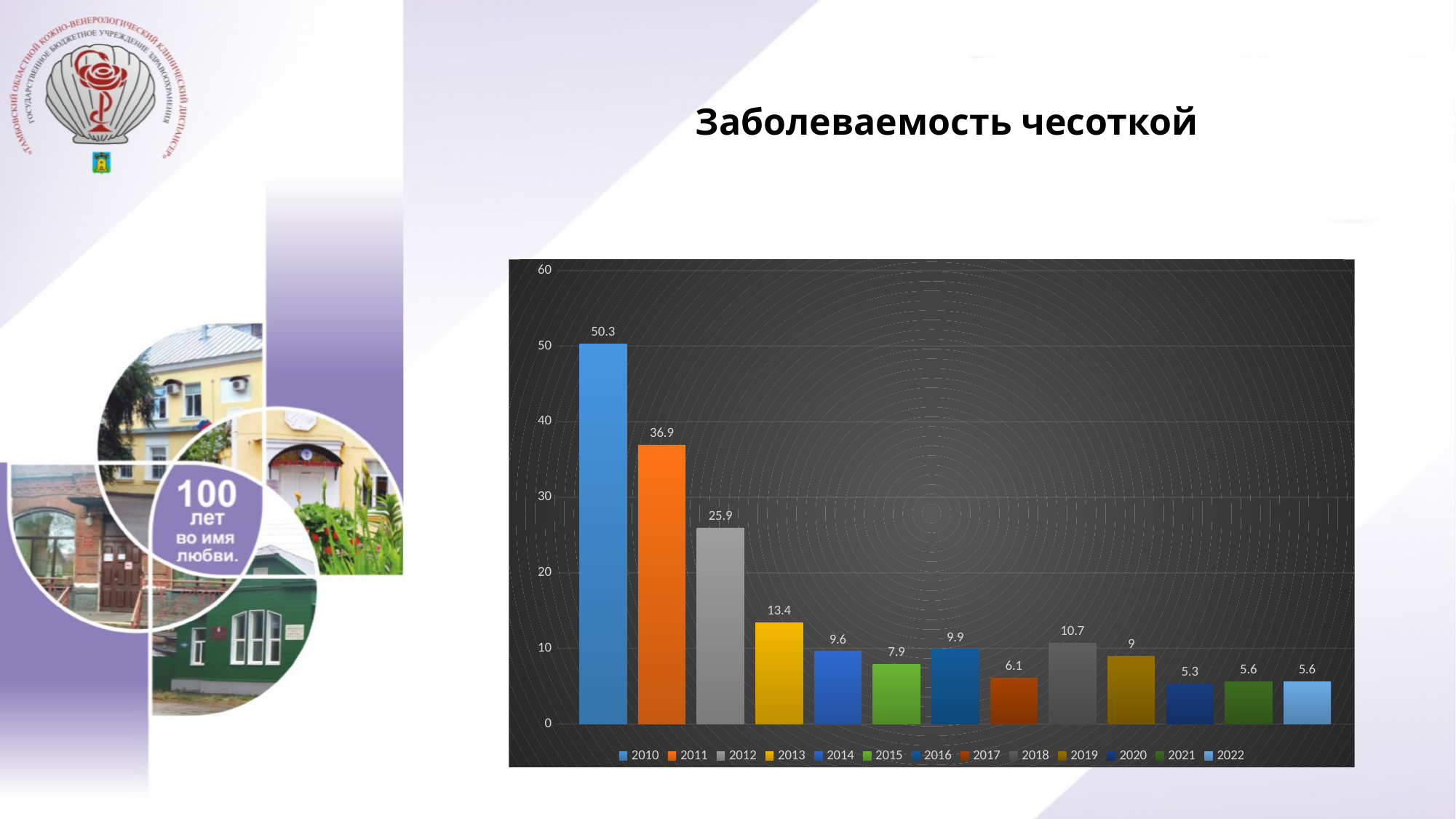
What is the value shown for 2022? 5.6 What is the difference between the values for 2010 and 2011? 13.4 Which year has the lowest value? 2020 How many bars are plotted in the chart? 13 Which year has the highest value? 2010 How many entries does the legend list? 13 What is the value shown for 2018? 10.7 What is the value shown for 2010? 50.3 What is the title of the slide? Заболеваемость чесоткой Which is larger, the value for 2016 or the value for 2017? 2016 What kind of chart is shown on the slide? Bar chart Is the value for 2012 greater or less than 20? greater